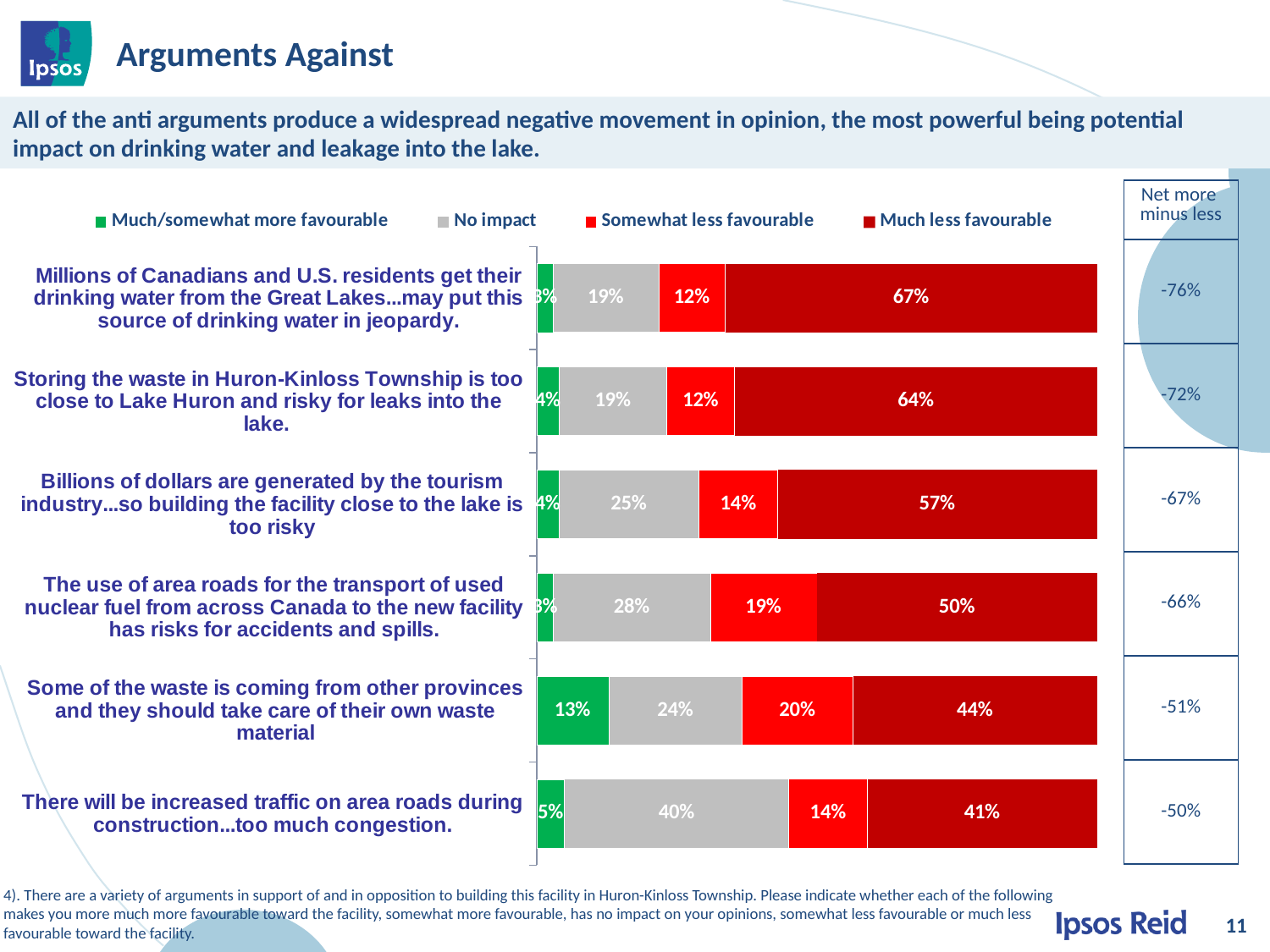
Which is larger: the 'No impact' value for the area roads transport of nuclear fuel argument or the 'No impact' value for the tourism industry argument? The area roads transport of nuclear fuel argument (28%) What is the 'Somewhat less favourable' value for the argument about waste coming from other provinces? 20% Which argument has the lowest 'Much less favourable' value? There will be increased traffic on area roads during construction...too much congestion. What is the 'Much less favourable' value for the argument about drinking water from the Great Lakes? 67% What is the 'Net more minus less' value shown for the argument about storing waste in Huron-Kinloss Township close to Lake Huron? -72% How many arguments (categories) are plotted in the chart? 6 What is the 'No impact' value for the argument about increased traffic on area roads during construction? 40% How many series does the legend list? 4 What is the 'Much/somewhat more favourable' value for the argument about waste coming from other provinces? 13% What kind of chart is shown on the slide? stacked bar chart Which argument has the highest 'Much less favourable' value? Millions of Canadians and U.S. residents get their drinking water from the Great Lakes...may put this source of drinking water in jeopardy. What is the difference between the 'Much less favourable' values for the drinking water argument and the tourism industry argument? 10%